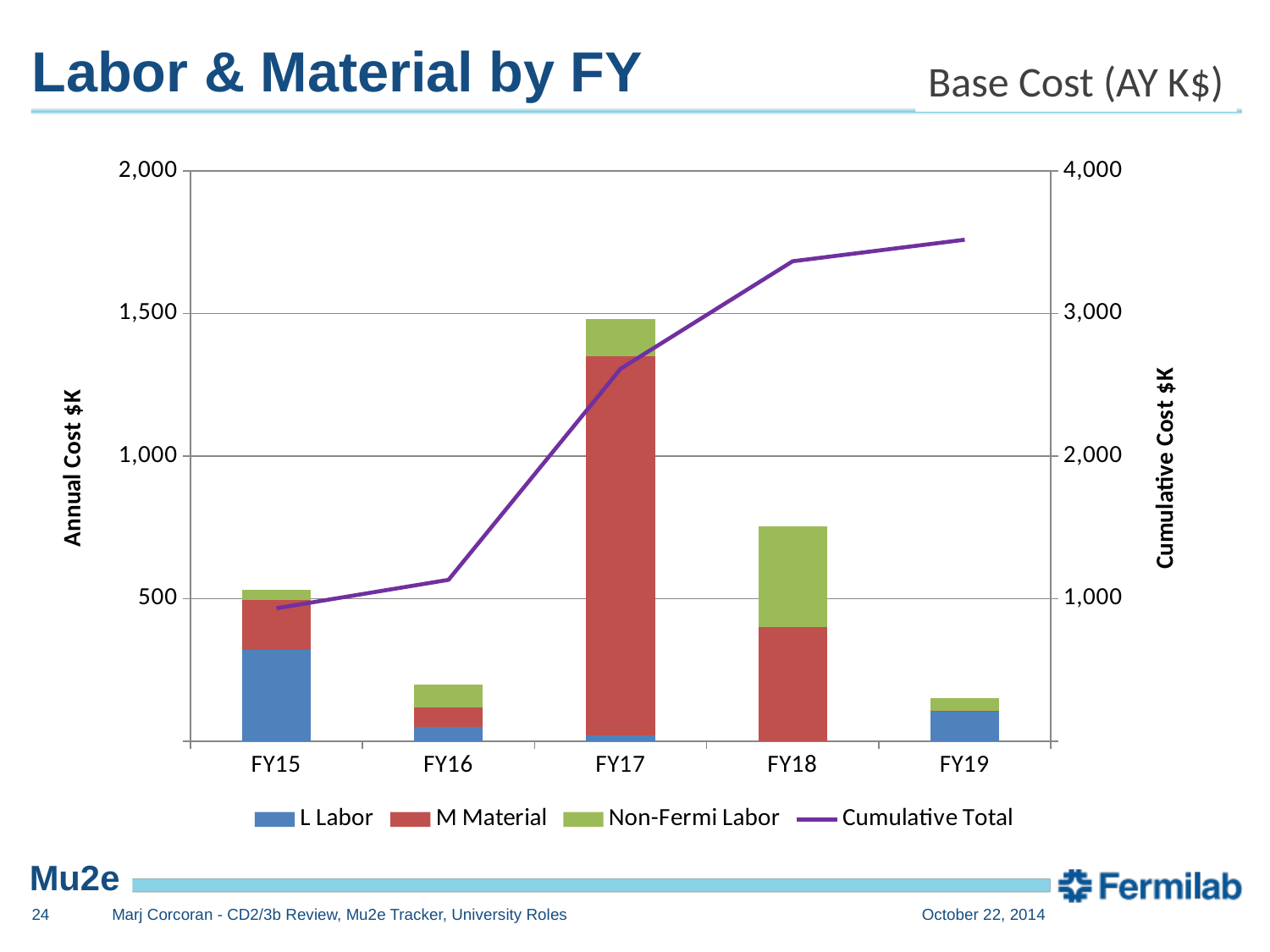
How many series does the legend list? 4 Which has the larger total annual cost, FY17 or FY18? FY17 Which fiscal year has the tallest stacked bar for annual cost? FY17 Is the Cumulative Total for FY19 greater or less than 3,000 on the right axis? greater Is the total annual cost for FY17 greater or less than 1,000? greater Is the Cumulative Total for FY15 greater or less than 1,000 on the right axis? less What is the title of the right-hand vertical axis? Cumulative Cost $K How many fiscal years are shown on the x axis? 5 Does the Cumulative Total line rise or fall from FY15 to FY19? rise What kind of chart is shown on the slide? bar chart (stacked) with a line Which fiscal year has the shortest stacked bar for annual cost? FY19